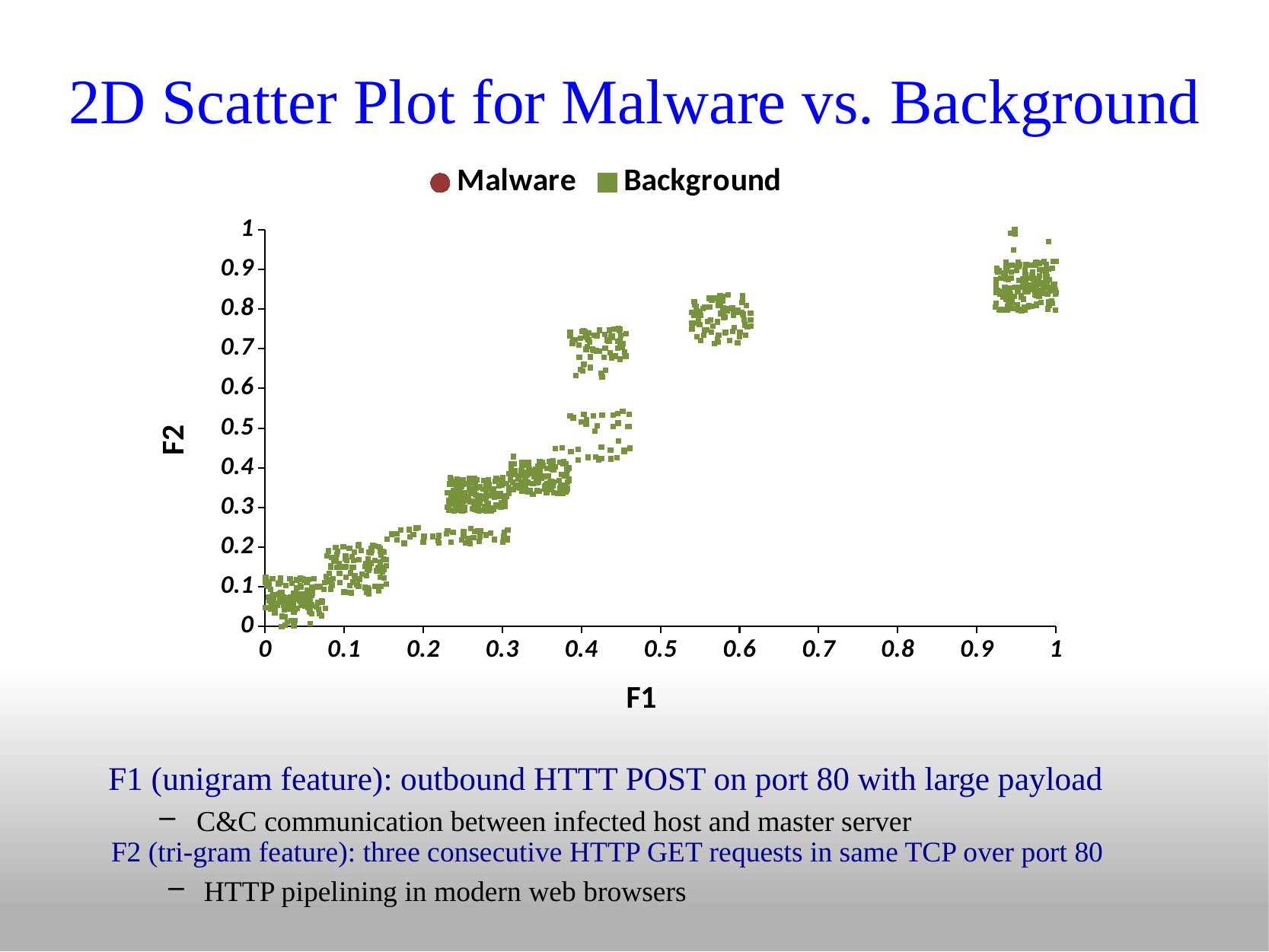
Is the F2 value of the Background cluster located near F1 = 0.57 greater or less than 0.6? greater Is the F2 value of the Background cluster located near F1 = 0.95 greater or less than 0.5? greater Which series' points are visible on the plot, Malware or Background? Background What is the label of the vertical axis? F2 How many series does the legend list? 2 What are the two series named in the legend? Malware and Background What is the label of the horizontal axis? F1 Is the F2 value of the Background cluster located near F1 = 0.25 greater or less than 0.5? less What kind of chart is shown on the slide? scatter plot As F1 increases along the x axis, do the Background points generally rise or fall in F2? rise